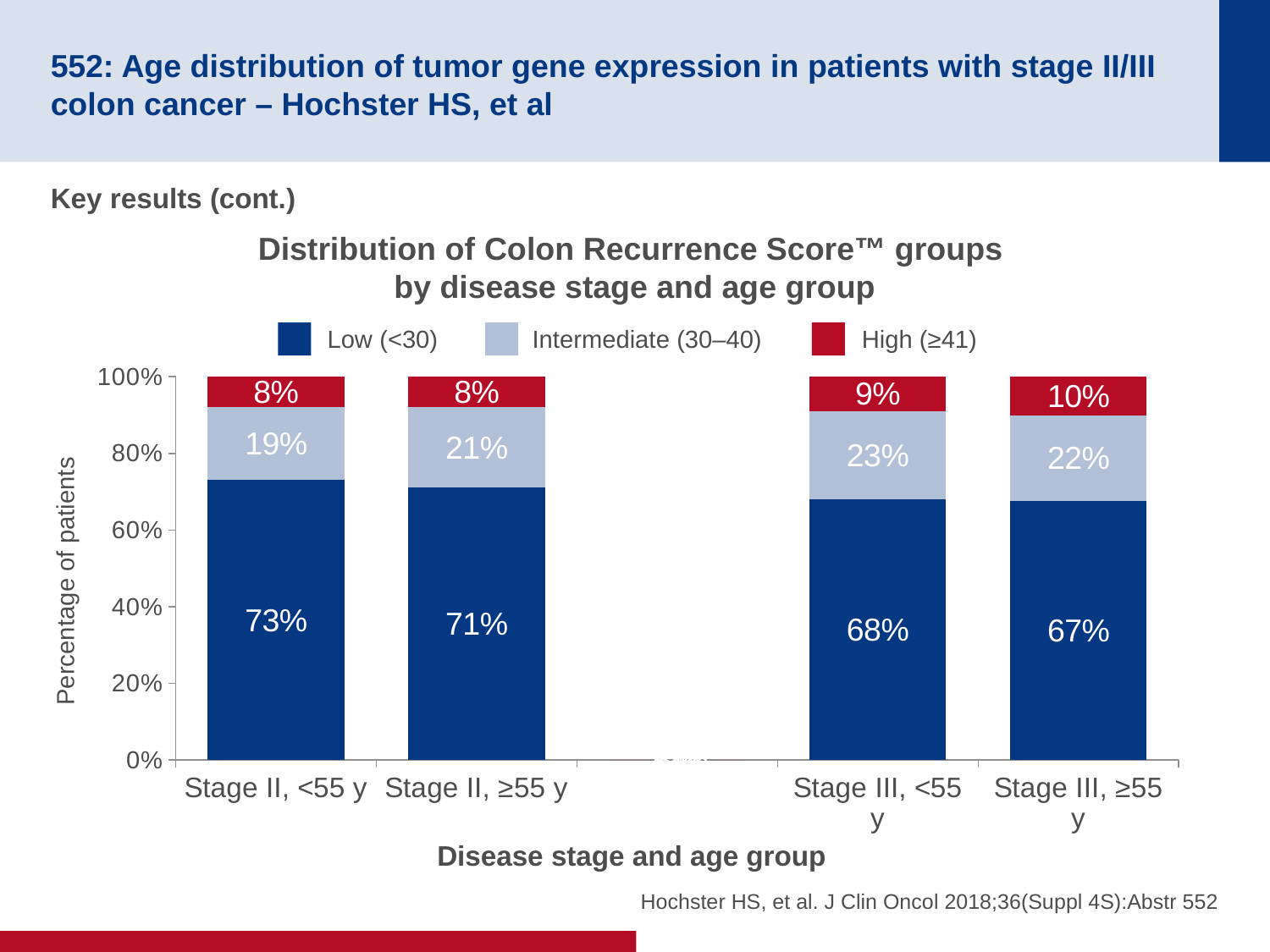
What is the title of the chart? Distribution of Colon Recurrence Score™ groups by disease stage and age group Which disease stage and age group has the highest percentage of patients in the Low (<30) group? Stage II, <55 y How many series does the legend list? 3 What kind of chart is shown? Stacked bar chart Which disease stage and age group has the lowest percentage of patients in the Low (<30) group? Stage III, ≥55 y What percentage of Stage II, <55 y patients are in the Low (<30) group? 73% How many disease stage and age groups are shown on the x axis? 4 Does the Low (<30) percentage rise or fall moving from Stage II, <55 y to Stage III, ≥55 y along the x axis? Fall Which has a larger Intermediate (30–40) percentage: Stage II, ≥55 y or Stage III, <55 y? Stage III, <55 y What percentage of Stage III, ≥55 y patients are in the High (≥41) group? 10% What is the difference in the Low (<30) percentage between Stage II, <55 y and Stage III, ≥55 y? 6% What percentage of Stage III, <55 y patients are in the Intermediate (30–40) group? 23%